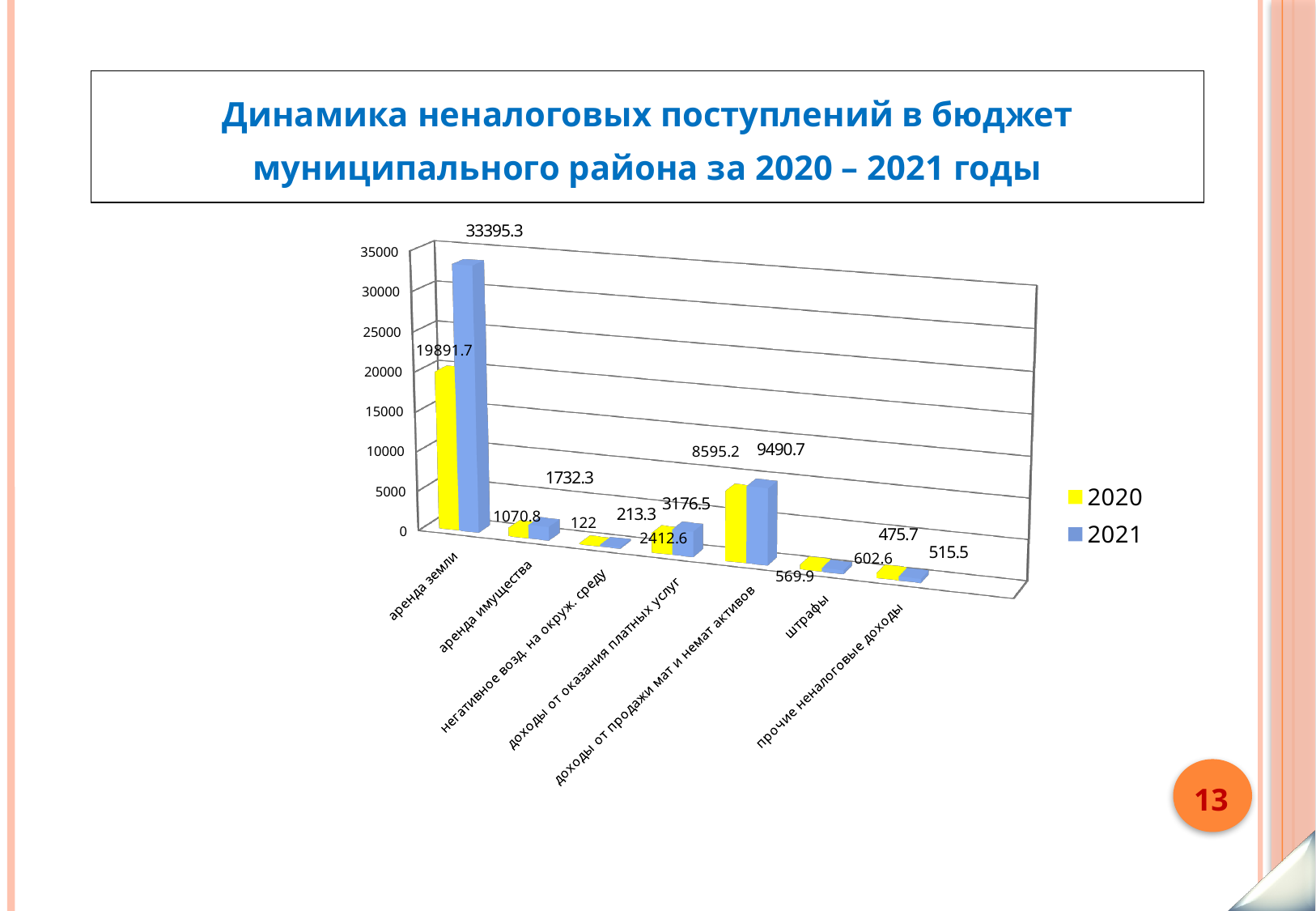
Which category has the highest value in 2021? аренда земли What is the difference between the 2021 and 2020 values for аренда земли? 13503.6 How many categories are shown on the x axis? 7 Which is larger for доходы от оказания платных услуг: the 2020 value or the 2021 value? 2021 What type of chart is shown on the slide? bar chart Which category has the lowest value in 2020? негативное возд. на окруж. среду What is the value for аренда земли in 2021? 33395.3 What is the value for доходы от продажи мат и немат активов in 2021? 9490.7 Which colour represents the 2020 series in the legend? yellow What is the value for негативное возд. на окруж. среду in 2020? 122 How many series does the legend list? 2 What is the value for аренда земли in 2020? 19891.7